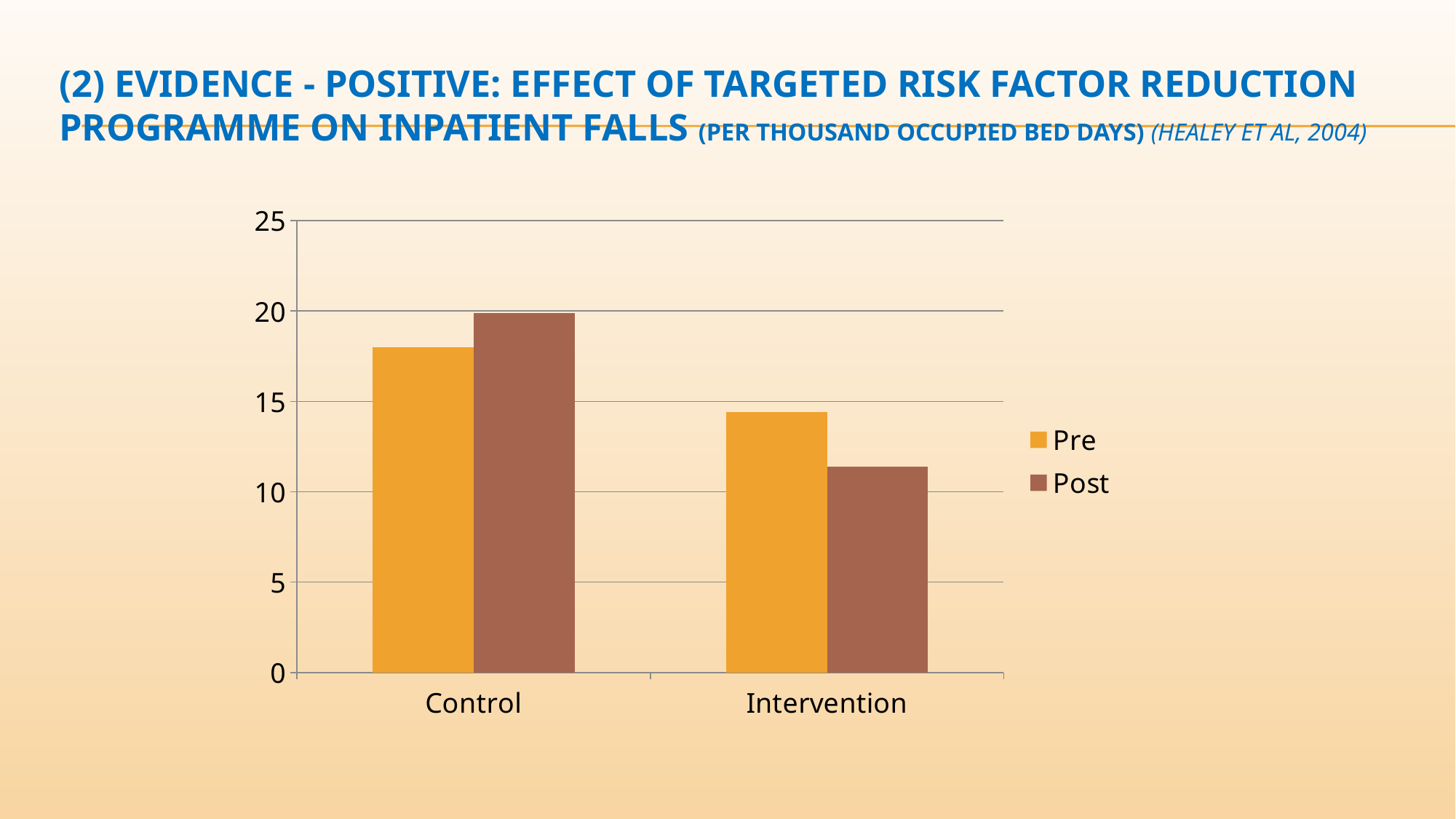
How many series does the legend list? 2 What kind of chart is shown on the slide? Bar chart How many categories are shown on the x axis of the chart? 2 What are the two legend entries of the chart? Pre and Post For the Control group, which is larger, the Pre value or the Post value? Post Which bar is the tallest in the chart? Control, Post Which series is shown in brown in the chart? Post Is the Post value for Intervention greater or less than 15? less For the Intervention group, which is larger, the Pre value or the Post value? Pre Is the Pre value for Control greater or less than 15? greater Is the Post value for Intervention greater or less than 10? greater Which bar is the shortest in the chart? Intervention, Post